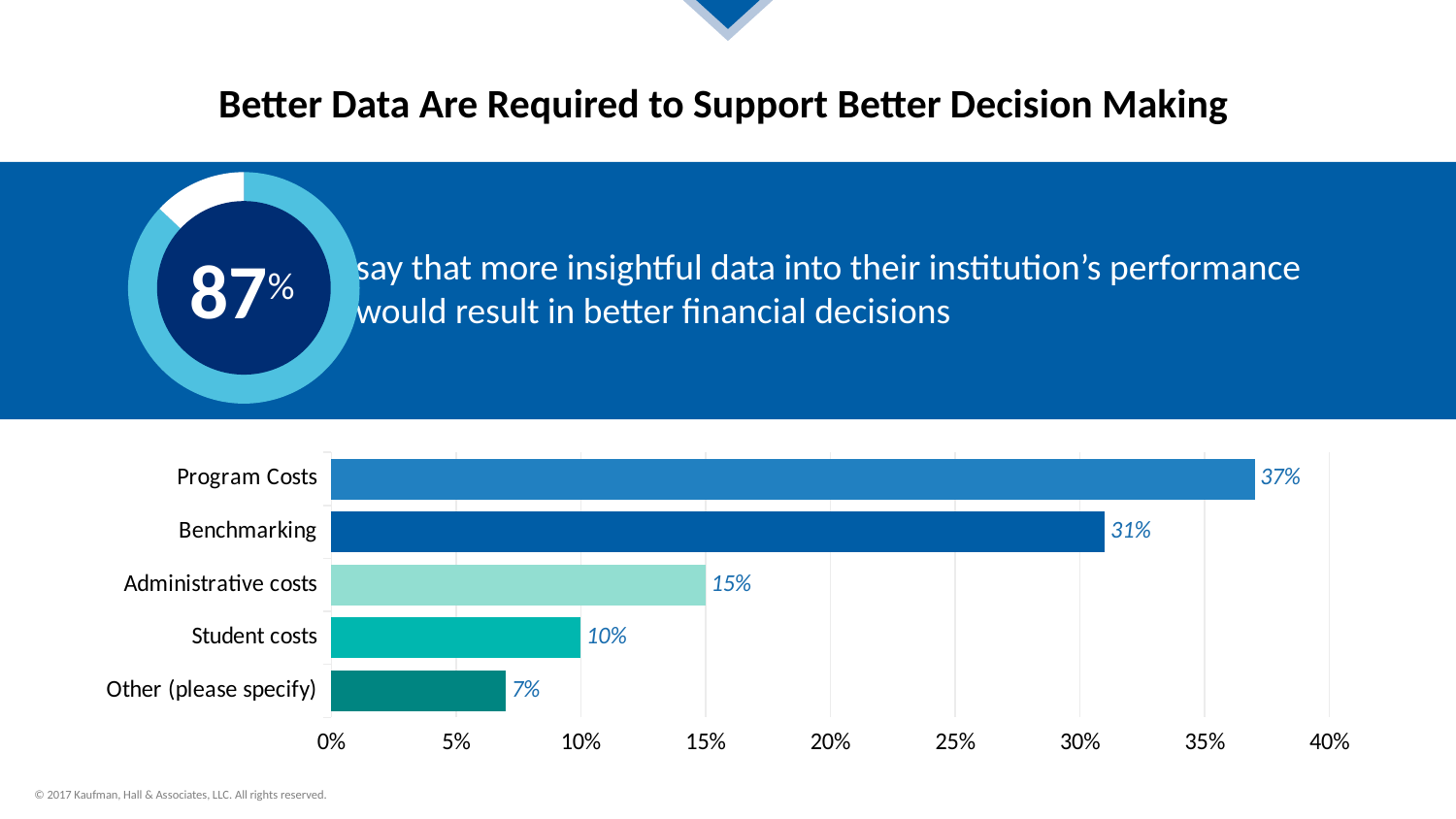
What percentage is shown in the donut chart in the blue band? 87% What is the value for Program Costs in the bar chart? 37% How many categories are shown in the bar chart? 5 What is the value for Student costs in the bar chart? 10% What kind of chart is shown at the bottom of the slide? Bar chart What is the value for Benchmarking in the bar chart? 31% Which is larger in the bar chart, Administrative costs or Student costs? Administrative costs What is the value for Administrative costs in the bar chart? 15% What is the value for Other (please specify) in the bar chart? 7% What is the difference between the values for Program Costs and Benchmarking in the bar chart? 6% Which category has the lowest value in the bar chart? Other (please specify) Which category has the highest value in the bar chart? Program Costs